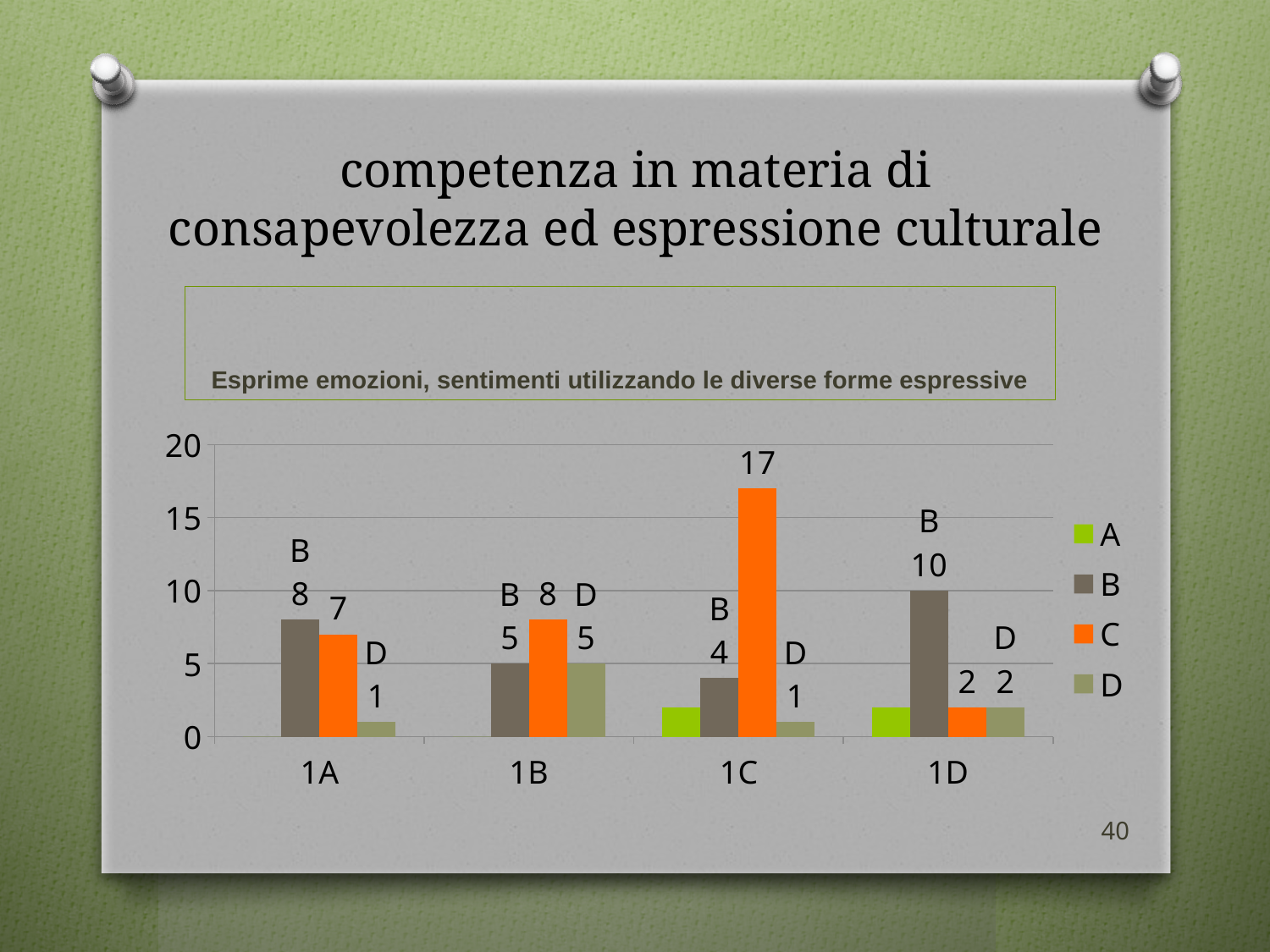
What is the value of series B for category 1D? 10 What is the value of series D for category 1B? 5 Is the value for series A in category 1C greater or less than 5? less What is the value of series C for category 1A? 7 For category 1B, which is larger: series B or series C? C Which category has the lowest value for series B? 1C What type of chart is shown on the slide? bar chart How many series does the legend list? 4 What is the value of series C for category 1C? 17 Which category has the highest value for series C? 1C What is the difference between series B and series C for category 1A? 1 What is the difference between the series C value for 1C and the series C value for 1B? 9